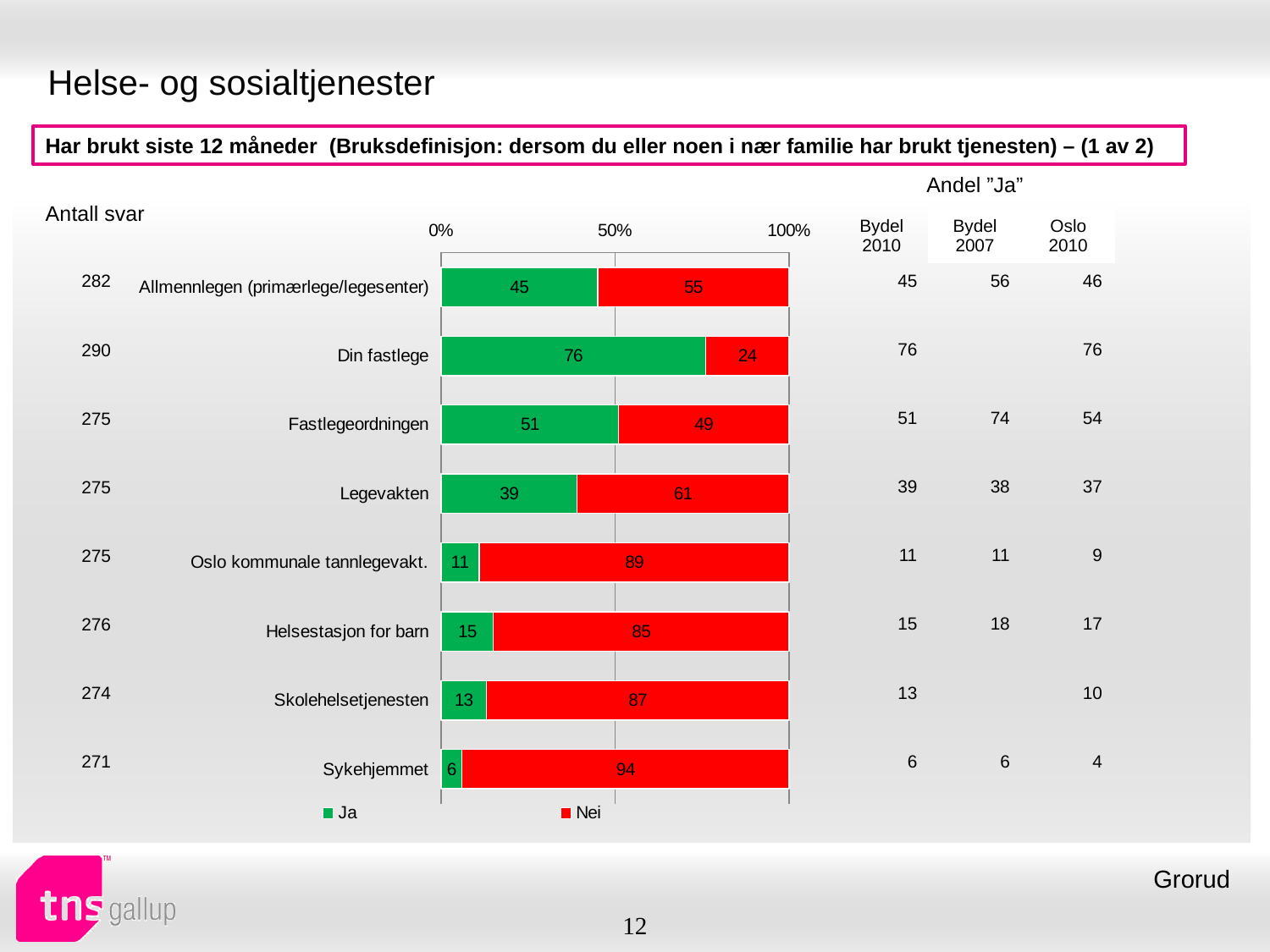
What is the "Ja" value for Din fastlege? 76 Which category has the highest "Ja" value? Din fastlege What is the "Nei" value for Oslo kommunale tannlegevakt.? 89 What is the total of the stacked bar for Skolehelsetjenesten? 100 What is the difference between the "Ja" values for Din fastlege and Fastlegeordningen? 25 Which has a larger "Ja" value, Legevakten or Helsestasjon for barn? Legevakten How many categories are shown in the chart? 8 Which category has the lowest "Ja" value? Sykehjemmet What are the two legend entries of the chart? Ja and Nei What kind of chart is shown on the slide? Stacked bar chart What colour represents "Nei" in the chart? Red How many series does the legend list? 2